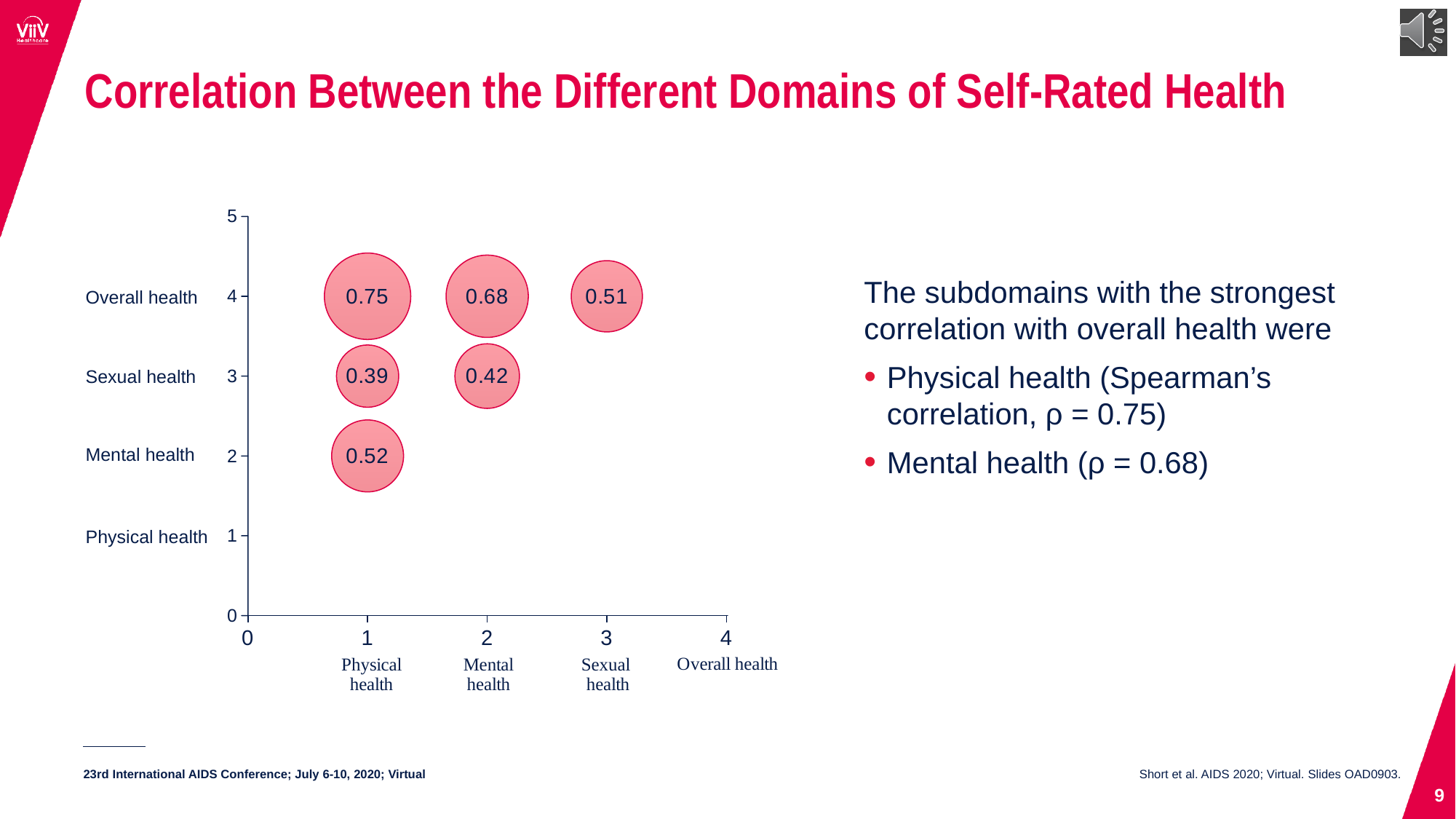
What is the correlation between mental health and sexual health shown in the chart? 0.42 Which is larger: the correlation of mental health with sexual health or the correlation of physical health with sexual health? Mental health with sexual health What is the correlation between sexual health and overall health shown in the chart? 0.51 What is the correlation between physical health and mental health shown in the chart? 0.52 Which pair of domains has the highest correlation value in the chart? Physical health and overall health What is the correlation between mental health and overall health shown in the chart? 0.68 Which pair of domains has the lowest correlation value in the chart? Physical health and sexual health What is the difference between the correlation of physical health with overall health and the correlation of mental health with overall health? 0.07 What is the correlation between physical health and sexual health shown in the chart? 0.39 How many bubbles (correlation values) are plotted in the chart? 6 What is the correlation between physical health and overall health shown in the chart? 0.75 What kind of chart is shown on the slide? Bubble chart